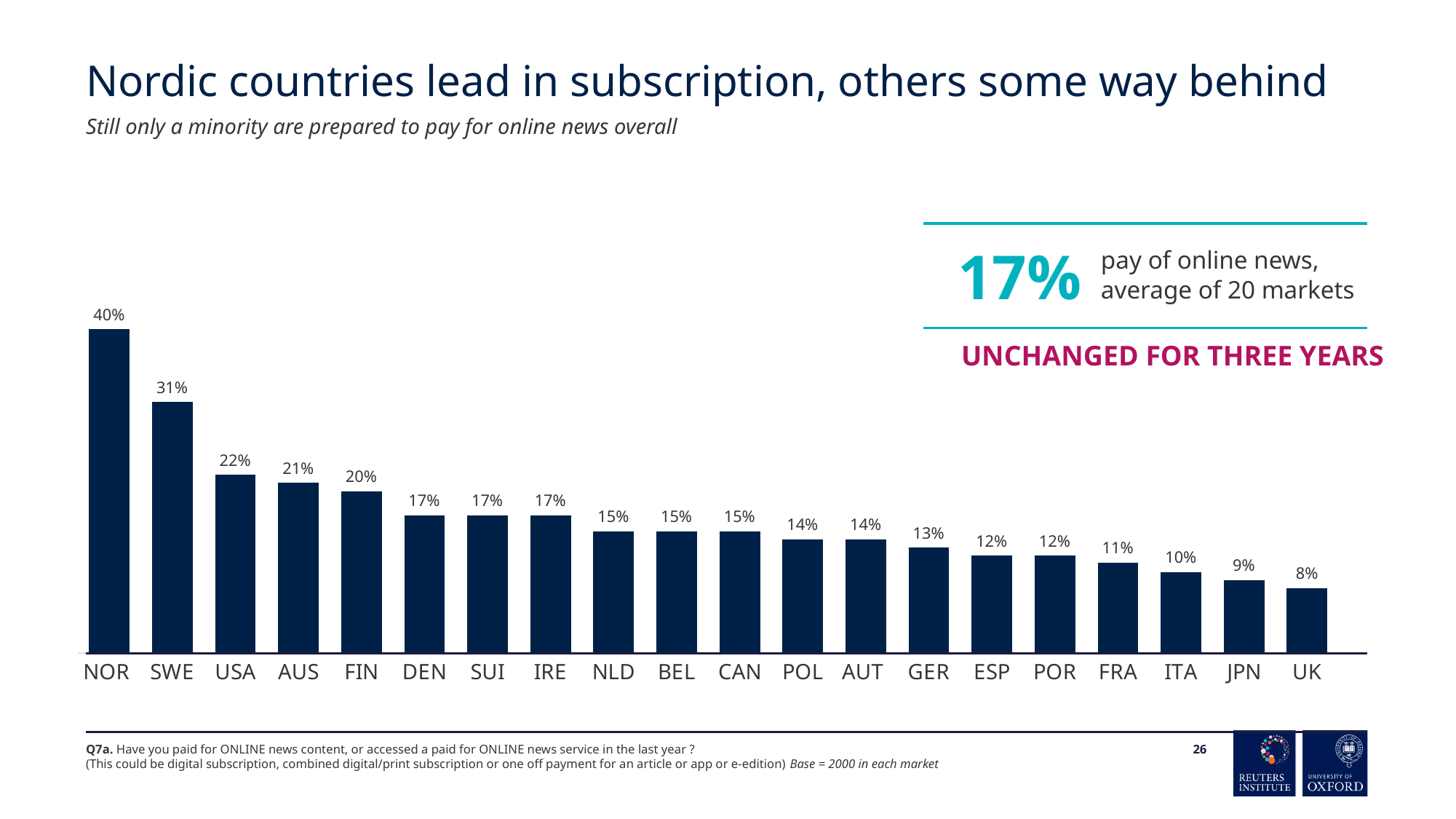
Which country has the highest share paying for online news? NOR Which country has the lowest share paying for online news? UK What percentage of people in NOR paid for online news? 40% What is the difference between the values for NOR and SWE? 9% What is the value shown for JPN? 9% What is the value shown for GER? 13% What kind of chart is shown on the slide? Bar chart Which has a higher value, FIN or DEN? FIN What is the difference between the values for USA and UK? 14% How many countries are shown in the chart? 20 What is the average of the 20 markets stated on the slide? 17% Do the values rise or fall from left to right across the countries? Fall